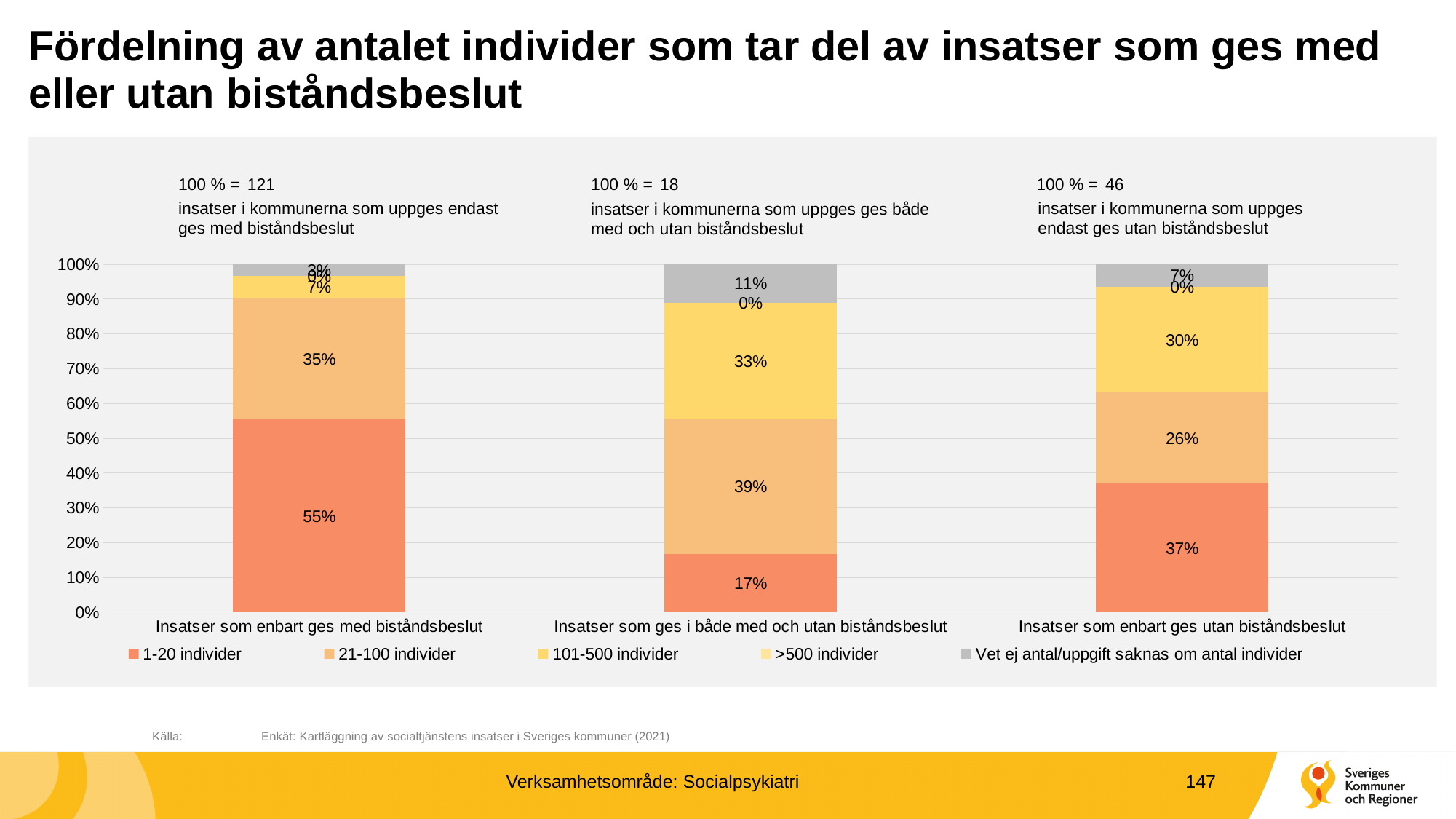
What is the share of 'Vet ej antal/uppgift saknas om antal individer' for 'Insatser som ges i både med och utan biståndsbeslut'? 11% What is the share of '1-20 individer' for 'Insatser som enbart ges med biståndsbeslut'? 55% Which category has the lowest share of '1-20 individer'? Insatser som ges i både med och utan biståndsbeslut Which category has the highest share of '1-20 individer'? Insatser som enbart ges med biståndsbeslut What is the share of '21-100 individer' for 'Insatser som ges i både med och utan biståndsbeslut'? 39% Which is larger: the '21-100 individer' share for 'Insatser som enbart ges med biståndsbeslut' or for 'Insatser som enbart ges utan biståndsbeslut'? Insatser som enbart ges med biståndsbeslut What is the difference between the '1-20 individer' share for 'Insatser som enbart ges med biståndsbeslut' and for 'Insatser som enbart ges utan biståndsbeslut'? 18 percentage points What is the share of '101-500 individer' for 'Insatser som enbart ges utan biståndsbeslut'? 30% How many series does the legend list? 5 How many insatser does 100 % correspond to for 'Insatser som enbart ges med biståndsbeslut'? 121 How many categories (bars) are shown on the x axis? 3 What kind of chart is shown on the slide? stacked bar chart